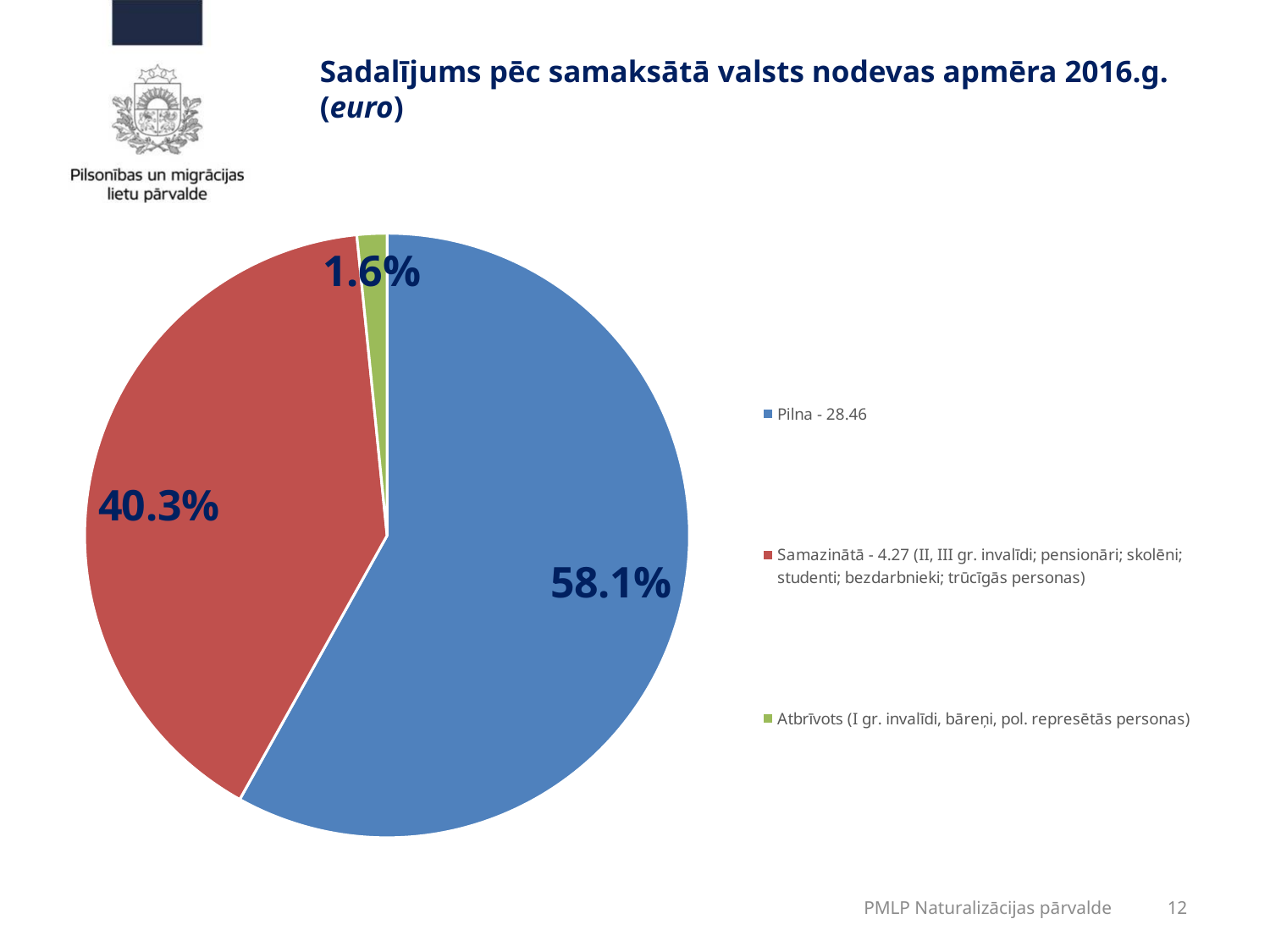
What is the title of the chart? Sadalījums pēc samaksātā valsts nodevas apmēra 2016.g. (euro) What share of the pie does the 'Pilna - 28.46' slice represent? 58.1% How many entries does the legend list? 3 How many slices does the pie chart have? 3 What is the difference in percentage points between the 'Pilna' slice and the 'Samazinātā' slice? 17.8 What kind of chart is shown on the slide? Pie chart What share of the pie does the 'Samazinātā - 4.27' slice represent? 40.3% Which category has the largest share of the pie? Pilna - 28.46 Which is larger, the 'Samazinātā - 4.27' slice or the 'Atbrīvots' slice? Samazinātā - 4.27 Which category has the smallest share of the pie? Atbrīvots (I gr. invalīdi, bāreņi, pol. represētās personas) What share of the pie does the 'Atbrīvots' slice represent? 1.6% What colour is the 'Pilna - 28.46' slice? Blue